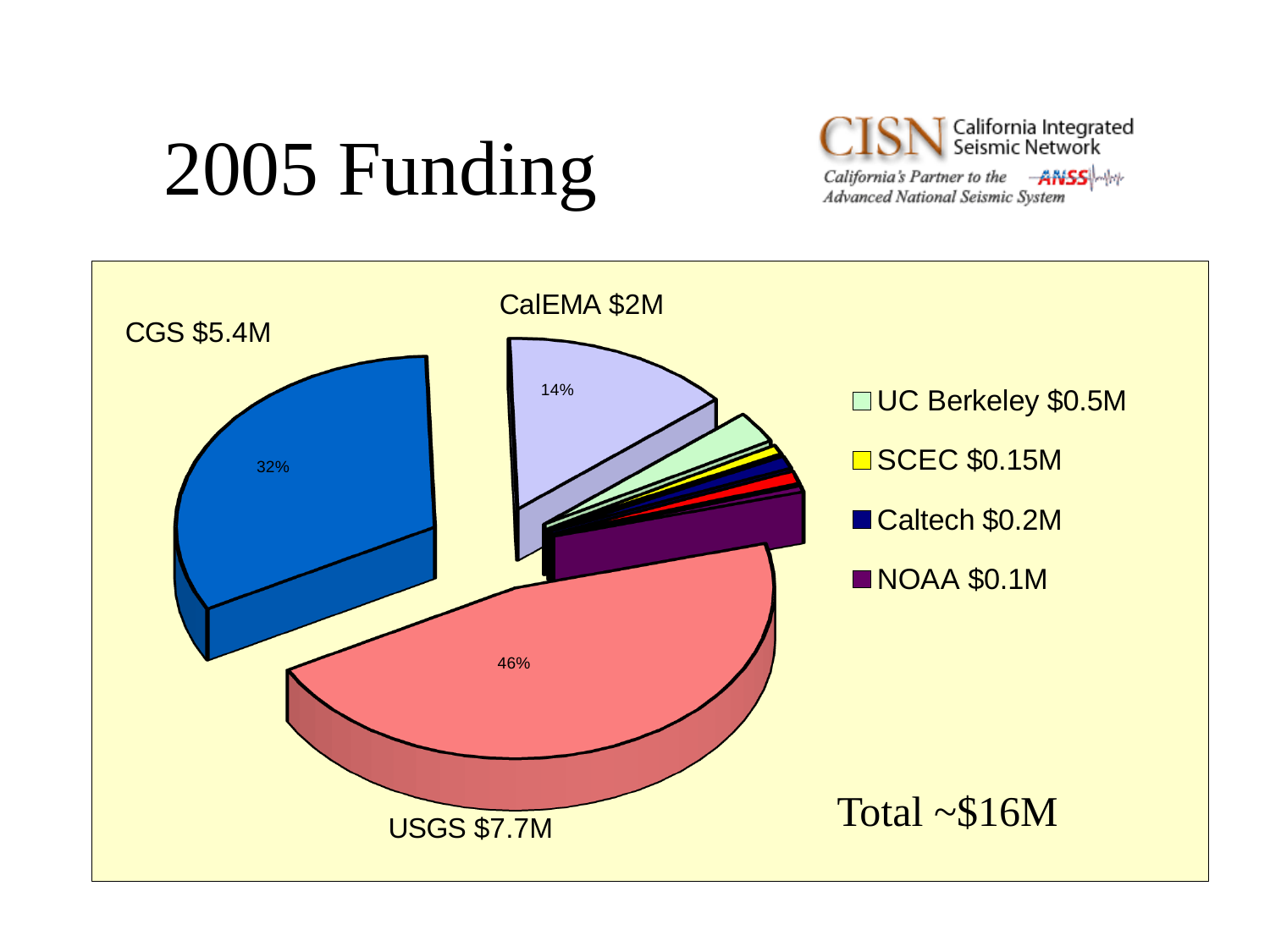
What is the funding amount for CGS? $5.4M What percentage of the pie does CGS represent? 32% How much more funding does USGS provide than CGS? $2.3M Which funding source has the smallest amount? NOAA What is the funding amount for USGS? $7.7M What kind of chart is shown on the slide? pie chart Which provides more funding, Caltech or UC Berkeley? UC Berkeley What percentage of the pie does CalEMA represent? 14% What is the funding amount for CalEMA? $2M What is the funding amount for SCEC? $0.15M Which funding source has the largest share of the pie? USGS